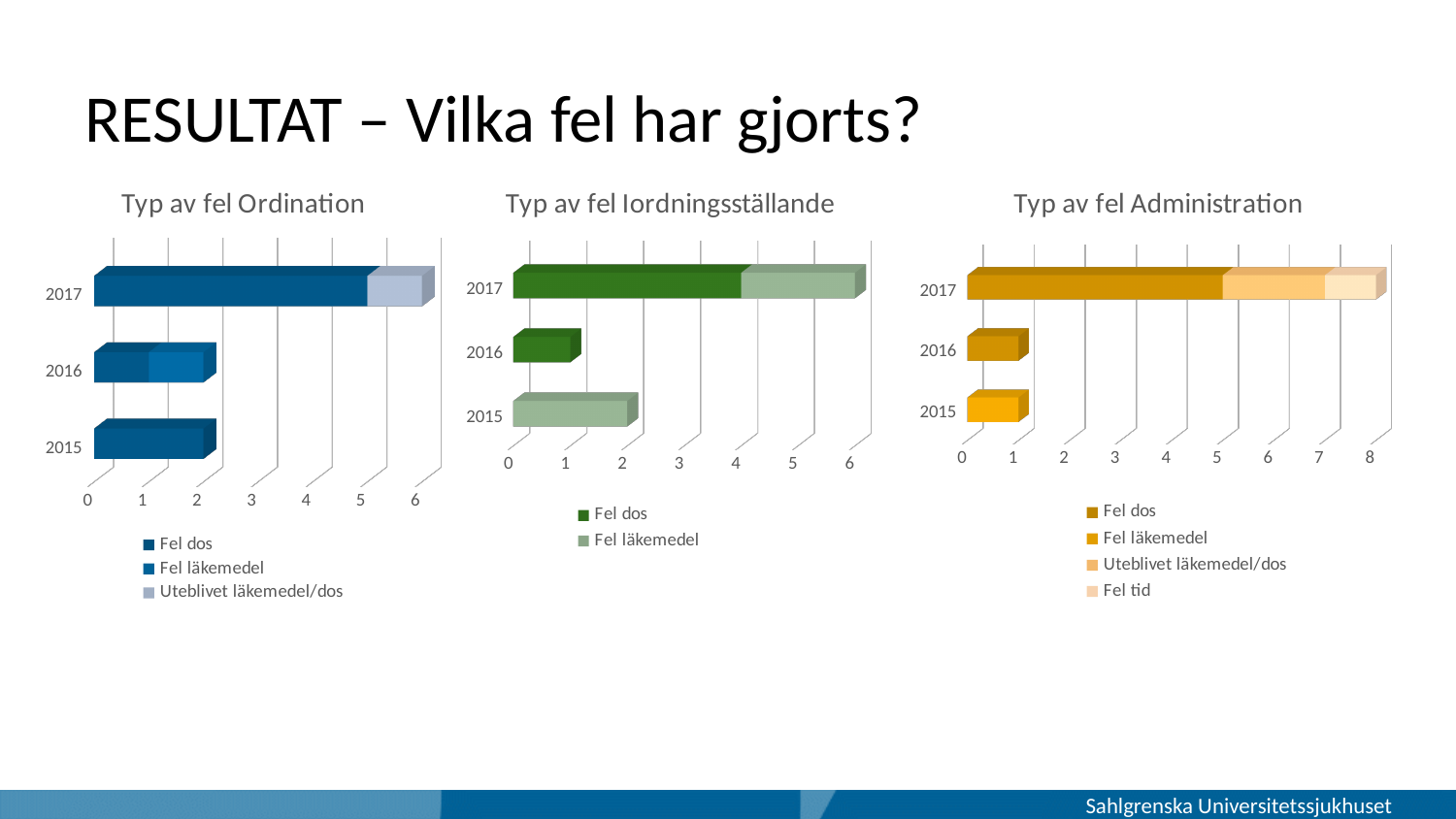
How many series does the legend of the 'Typ av fel Iordningsställande' chart list? 2 How many series does the legend of the 'Typ av fel Administration' chart list? 4 What is the highest value shown on the x axis of the 'Typ av fel Administration' chart? 8 In the 'Typ av fel Ordination' chart, which year has the longest total bar? 2017 How many years are shown on the y axis of the 'Typ av fel Administration' chart? 3 In the 'Typ av fel Iordningsställande' chart, is the value for 2016 greater or less than 2? less In the 'Typ av fel Iordningsställande' chart, which year has the shortest total bar? 2016 In the 'Typ av fel Ordination' chart, is the total value for 2017 greater or less than 4? greater In the 'Typ av fel Administration' chart, which year has the highest total? 2017 In the 'Typ av fel Administration' chart, is the total value for 2017 greater or less than 6? greater In the 'Typ av fel Ordination' chart, which is larger, the total for 2017 or the total for 2016? 2017 What kind of chart is 'Typ av fel Ordination'? Bar chart